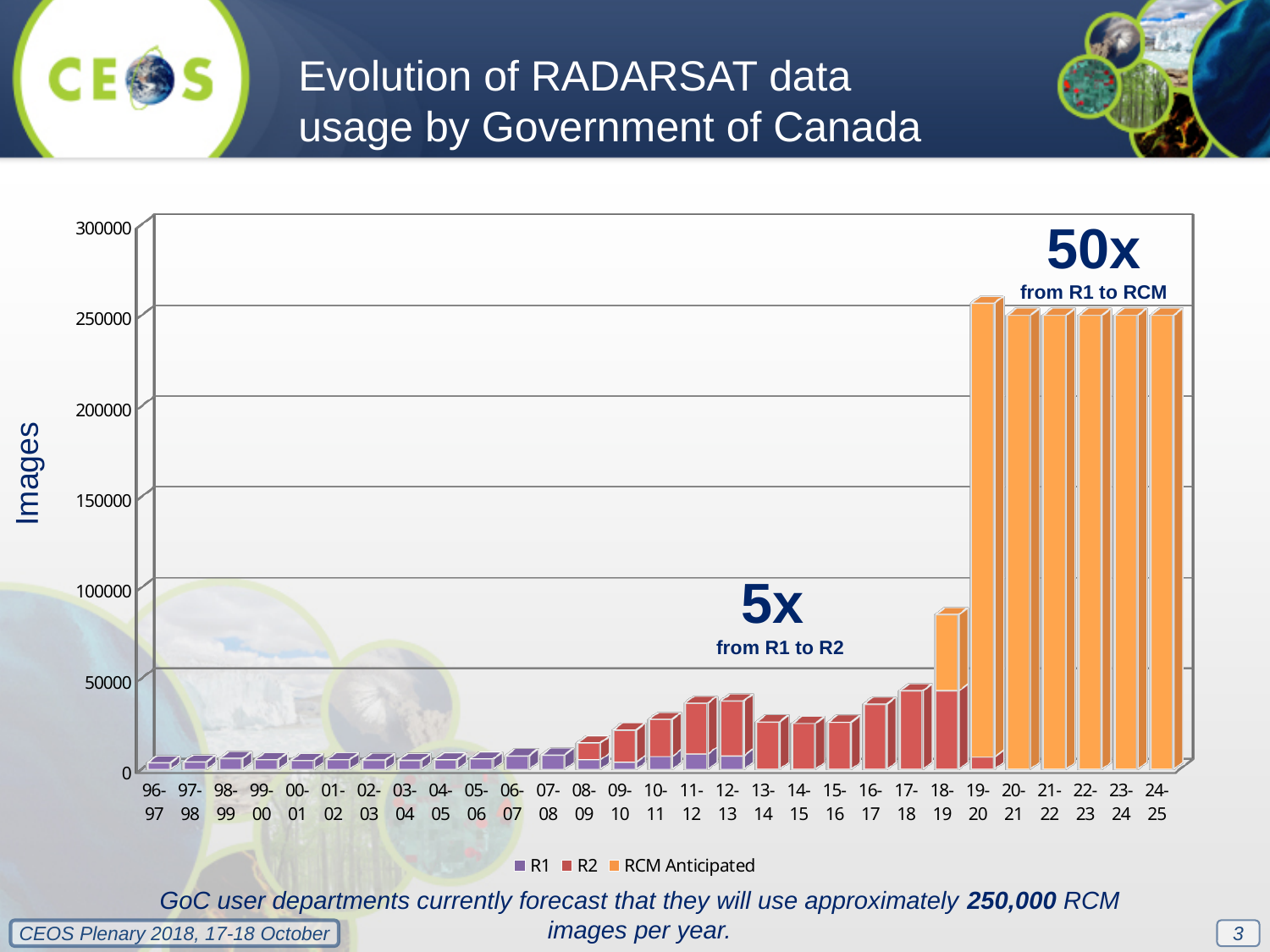
Which has the larger total value, 17-18 or 18-19? 18-19 What is the label on the vertical axis of the chart? Images Is the total value for 18-19 greater or less than 100000? less How many year categories are shown along the x axis of the chart? 29 Overall, do the values rise or fall from 96-97 to 24-25? rise What kind of chart is shown on the slide? bar chart How many series does the chart legend list? 3 Which series is shown in orange in the chart legend? RCM Anticipated Is the total value for 11-12 greater or less than 50000? less Which has the larger total value, 12-13 or 13-14? 12-13 Is the value for 96-97 greater or less than 50000? less